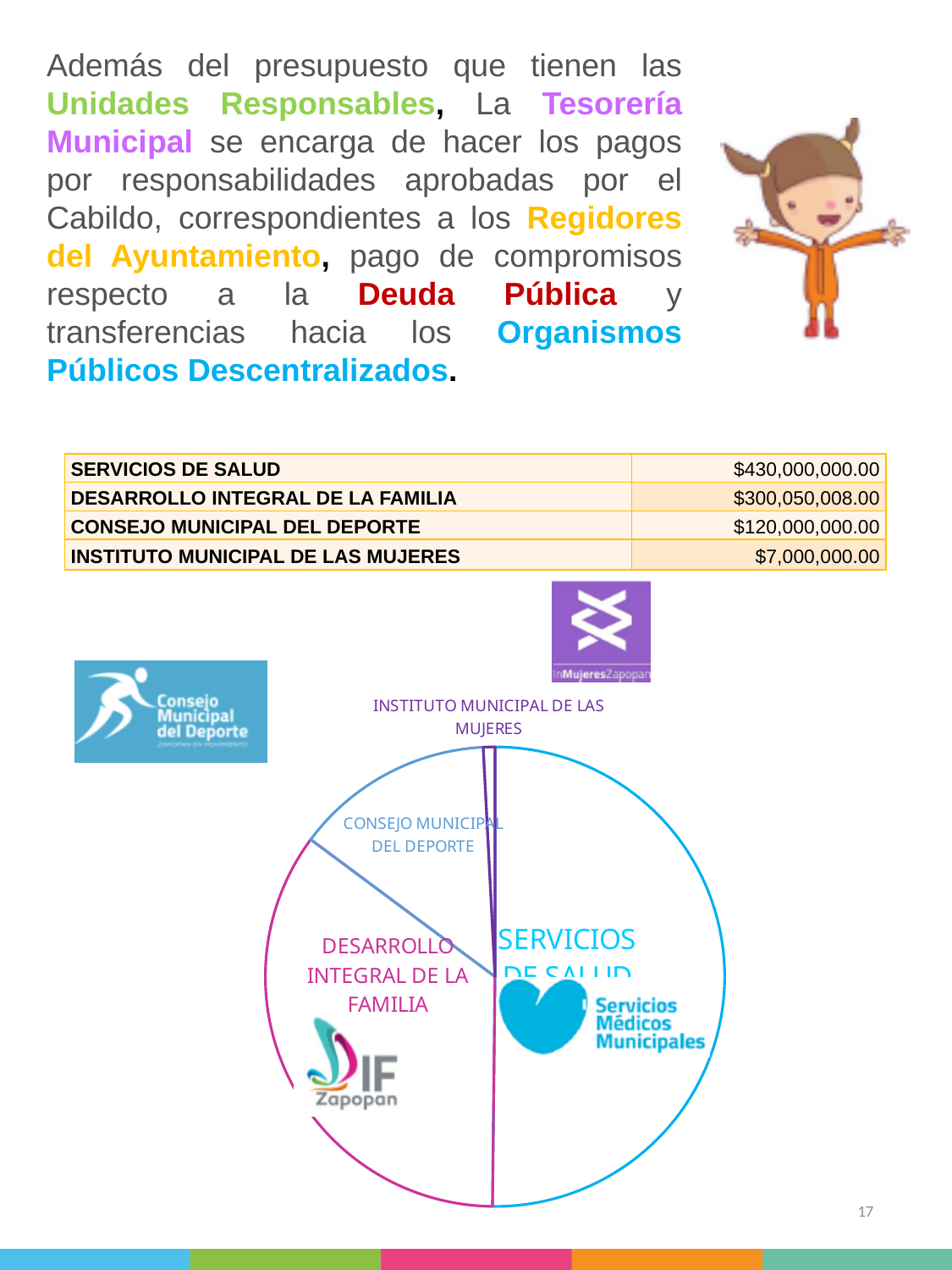
Which category has the smallest slice in the pie chart? INSTITUTO MUNICIPAL DE LAS MUJERES What kind of chart is shown on the slide? pie chart What colour is the SERVICIOS DE SALUD slice in the pie chart? blue According to the table, what is the value for SERVICIOS DE SALUD? $430,000,000.00 According to the table, what is the value for INSTITUTO MUNICIPAL DE LAS MUJERES? $7,000,000.00 Using the table values, what is the total of all four categories shown in the pie chart? $857,050,008.00 Which category has the largest slice in the pie chart? SERVICIOS DE SALUD Which slice is larger in the pie chart: DESARROLLO INTEGRAL DE LA FAMILIA or CONSEJO MUNICIPAL DEL DEPORTE? DESARROLLO INTEGRAL DE LA FAMILIA According to the table, what is the value for DESARROLLO INTEGRAL DE LA FAMILIA? $300,050,008.00 How many slices does the pie chart have? 4 Using the table values, what is the difference between SERVICIOS DE SALUD and DESARROLLO INTEGRAL DE LA FAMILIA? $129,949,992.00 According to the table, what is the value for CONSEJO MUNICIPAL DEL DEPORTE? $120,000,000.00